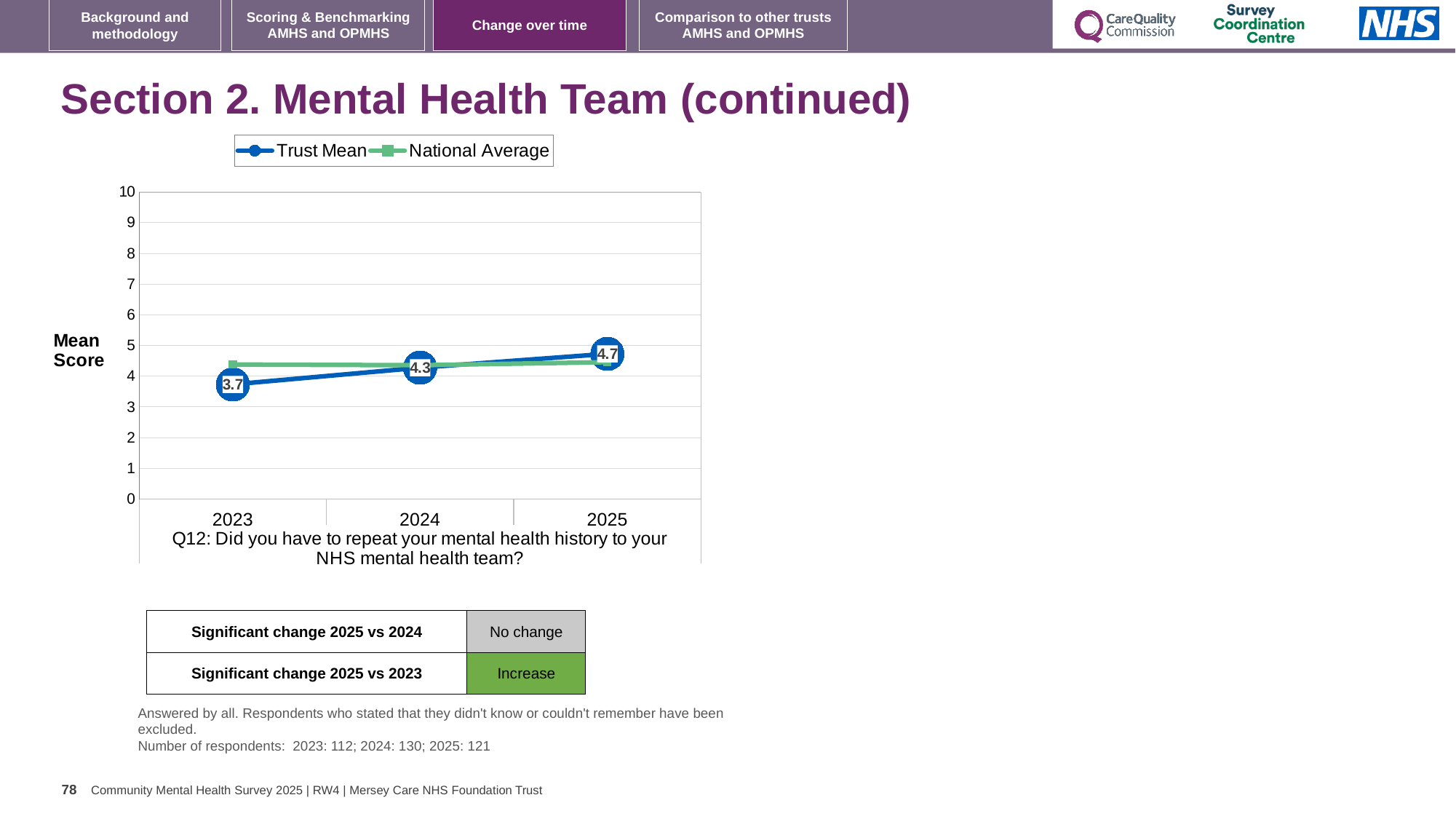
What is the Trust Mean score for 2025? 4.7 In which year is the Trust Mean lowest? 2023 Does the Trust Mean rise or fall from 2023 to 2025? Rise Is the National Average value for 2023 greater or less than 4? greater How many series does the legend list? 2 What is the Trust Mean score for 2024? 4.3 In 2023, which is higher: the Trust Mean or the National Average? National Average What is the Trust Mean score for 2023? 3.7 In which year is the Trust Mean highest? 2025 How many years are shown on the x axis? 3 What kind of chart is shown on the slide? Line chart By how much did the Trust Mean increase from 2023 to 2025? 1.0